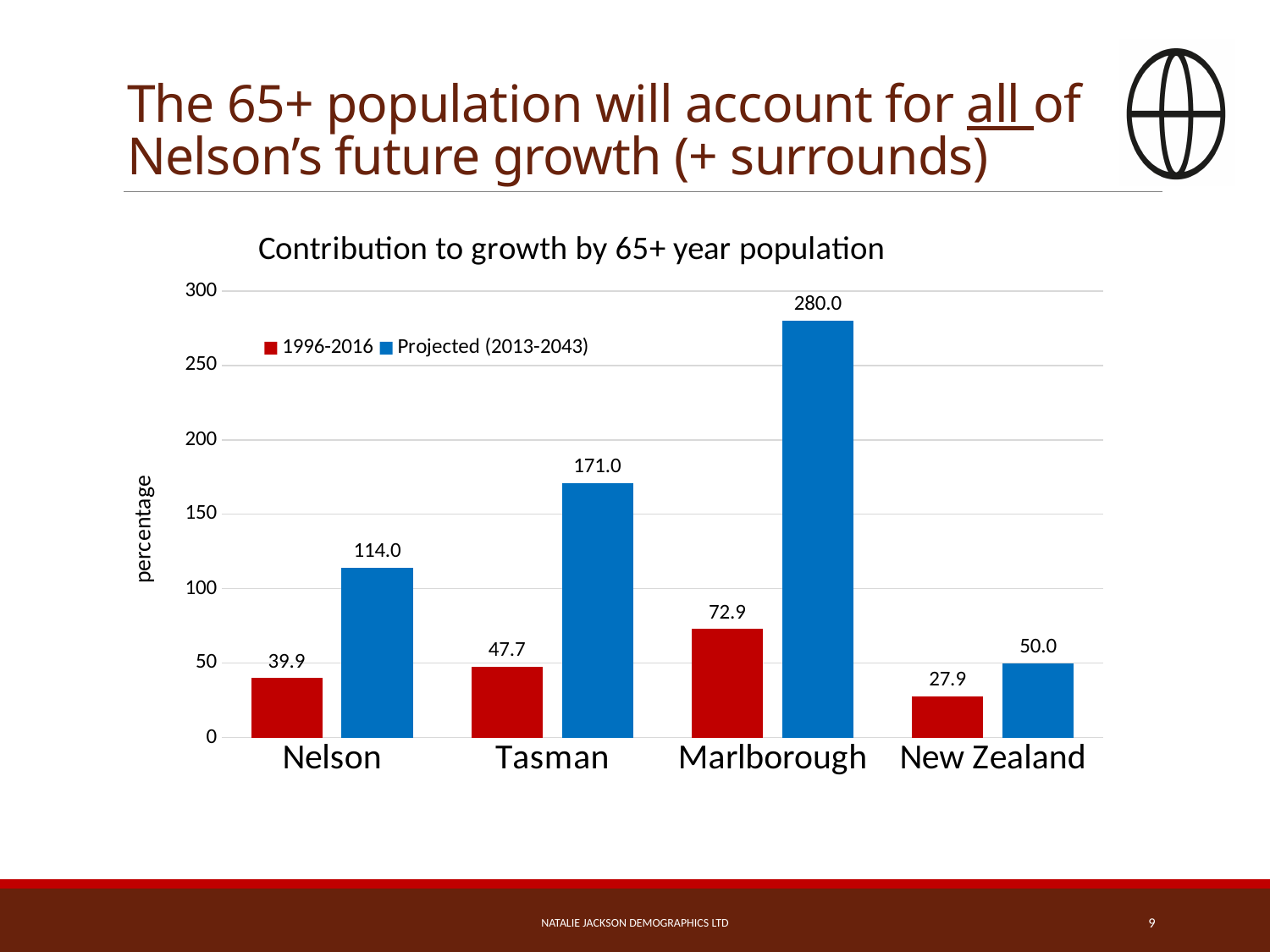
How many series does the legend list? 2 What is the Projected (2013-2043) value for New Zealand? 50.0 What is the difference between the Projected (2013-2043) and 1996-2016 values for Tasman? 123.3 How many categories are shown on the x axis? 4 Is the Projected (2013-2043) value for Nelson greater or less than 100? greater What is the Projected (2013-2043) value for Marlborough? 280.0 Which category has the lowest 1996-2016 value? New Zealand What is the title of the chart? Contribution to growth by 65+ year population What is the 1996-2016 value for Nelson? 39.9 Which category has the highest Projected (2013-2043) value? Marlborough What kind of chart is shown on the slide? bar chart Which is larger: the 1996-2016 value for Marlborough or the Projected (2013-2043) value for New Zealand? 1996-2016 value for Marlborough